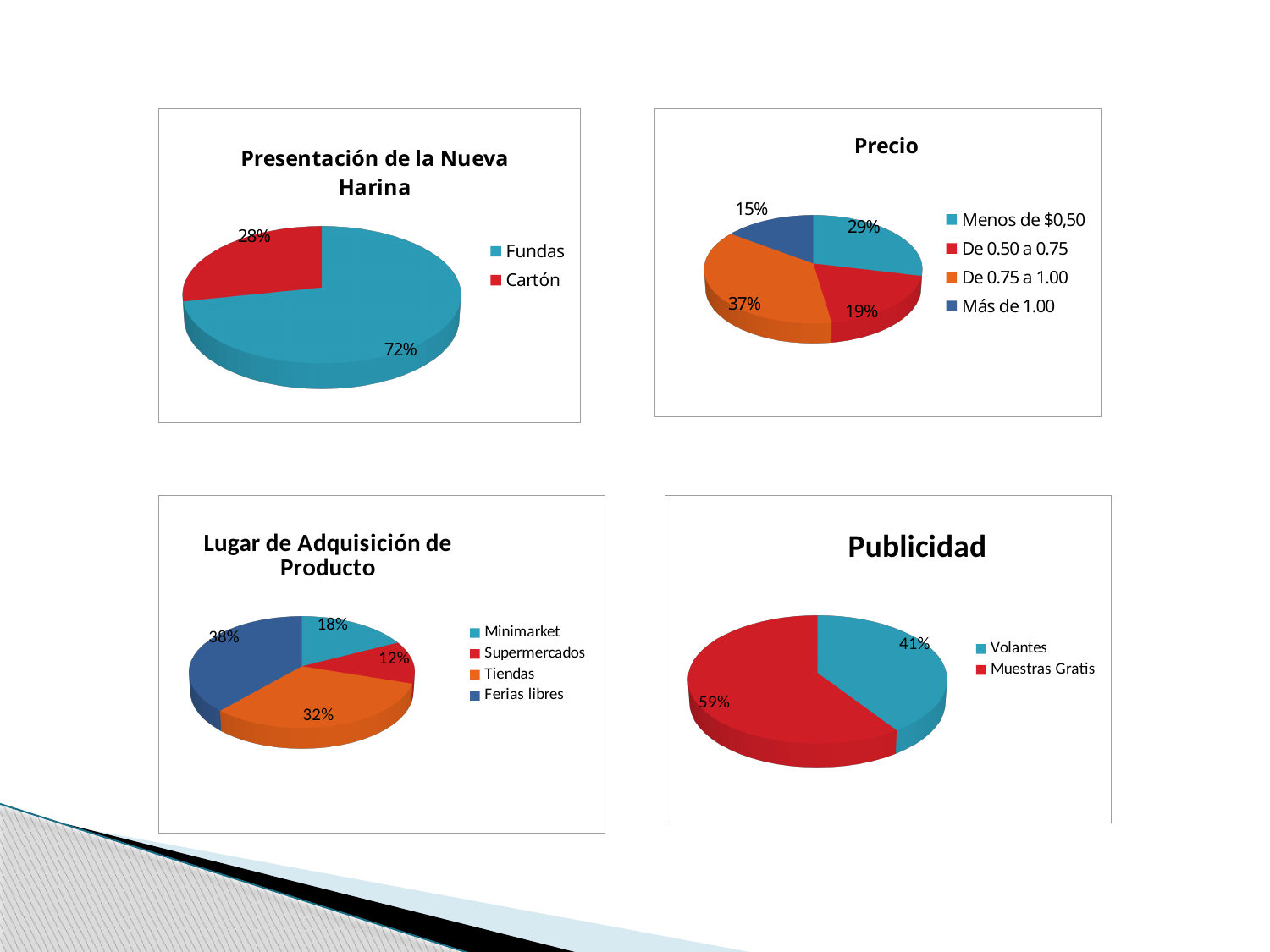
In the 'Presentación de la Nueva Harina' chart, what share does Fundas have? 72% In the 'Precio' chart, what share does 'De 0.75 a 1.00' have? 37% In the 'Lugar de Adquisición de Producto' chart, what is the difference between the shares of Ferias libres and Minimarket? 20% In the 'Precio' chart, which category has the smallest share? Más de 1.00 What type of chart is the 'Publicidad' chart? Pie chart In the 'Presentación de la Nueva Harina' chart, what share does Cartón have? 28% In the 'Lugar de Adquisición de Producto' chart, what share does Tiendas have? 32% In the 'Precio' chart, which category has the largest share? De 0.75 a 1.00 In the 'Publicidad' chart, which is larger, Volantes or Muestras Gratis? Muestras Gratis In the 'Lugar de Adquisición de Producto' chart, which category has the smallest share? Supermercados In the 'Publicidad' chart, what share does Volantes have? 41% In the 'Precio' chart, how many categories does the legend list? 4